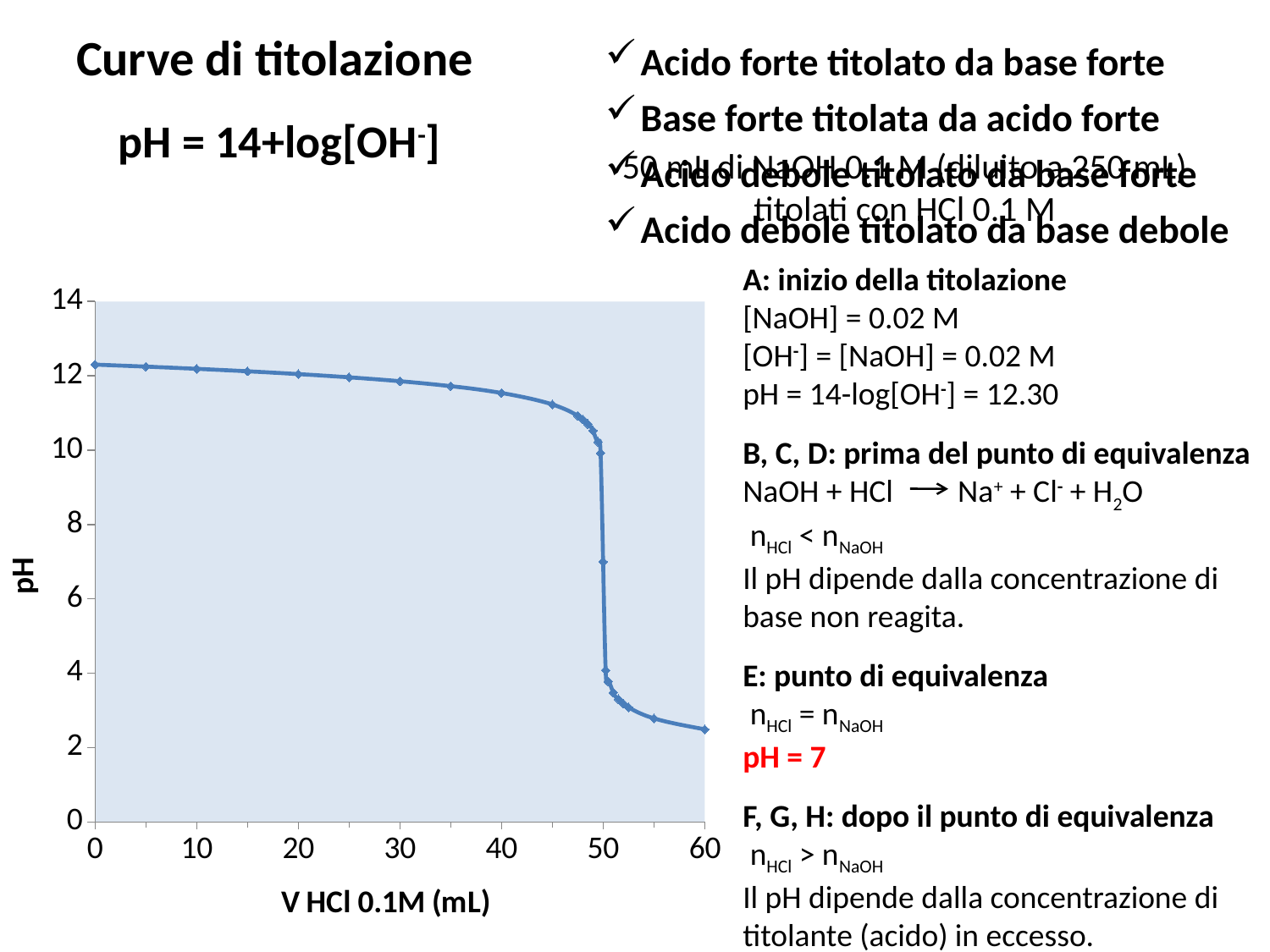
Is the pH at 20 mL of HCl greater or less than 8? greater Is the pH at 60 mL of HCl greater or less than 4? less At which volume of HCl on the x axis is the pH highest? 0 At which volume of HCl on the x axis is the pH lowest? 60 Is the pH at 0 mL of HCl greater or less than 12? greater What is the label of the x axis of the chart? V HCl 0.1M (mL) What is the label of the y axis of the chart? pH What kind of chart is shown on the slide? line chart Does the pH rise or fall as the volume of HCl increases along the x axis? fall Which has the higher pH: 10 mL of HCl or 55 mL of HCl? 10 mL